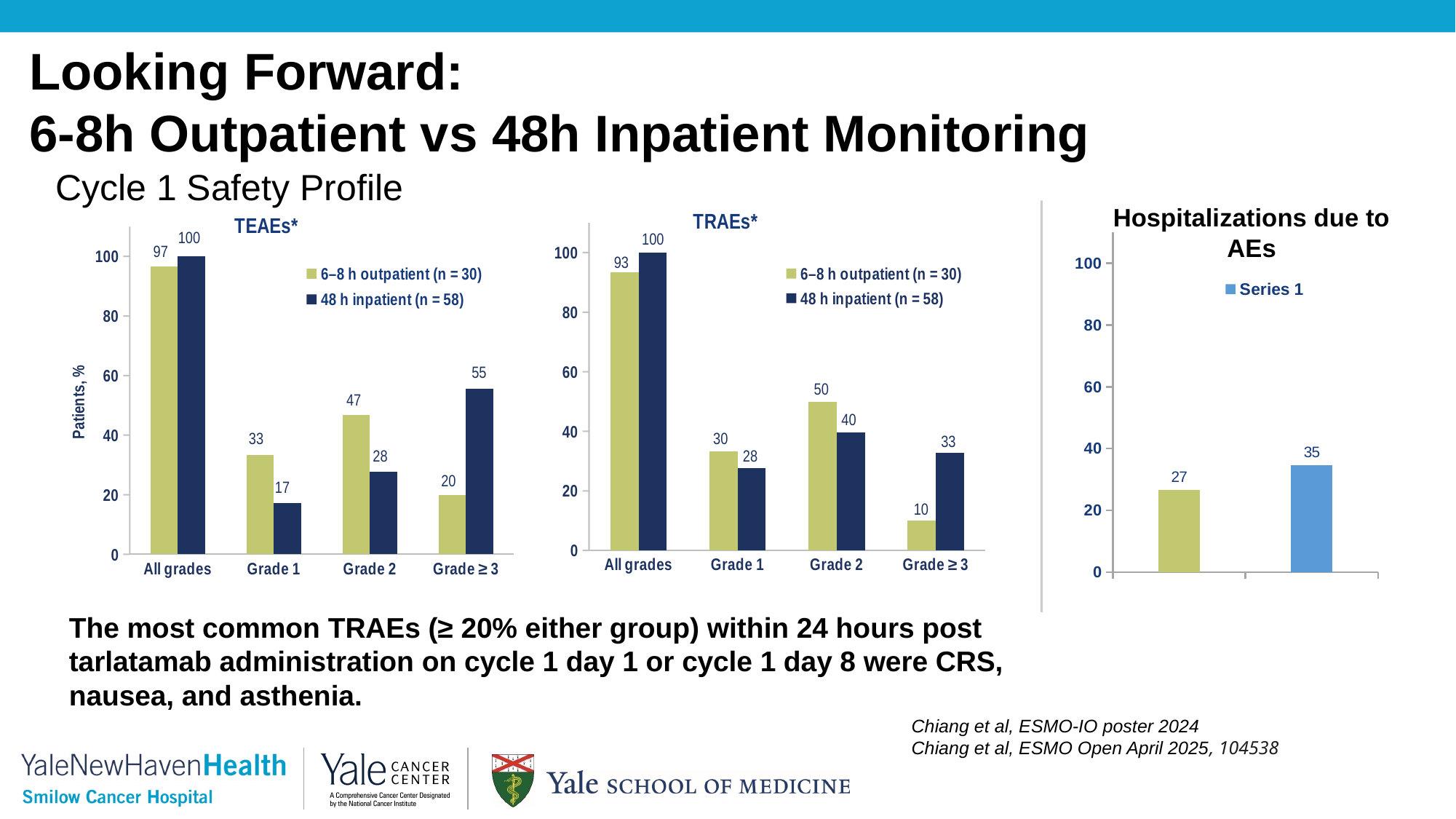
In the TEAEs* chart, what is the value for 48 h inpatient at Grade ≥ 3? 55 How many categories are shown on the x axis of the TEAEs* chart? 4 In the TRAEs* chart, what is the difference between the 48 h inpatient and 6–8 h outpatient values at Grade ≥ 3? 23 In the TEAEs* chart, which group has the higher value at Grade ≥ 3, 6–8 h outpatient or 48 h inpatient? 48 h inpatient In the Hospitalizations due to AEs chart, what is the highest value shown? 35 How many series does the legend of the TRAEs* chart list? 2 In the TEAEs* chart, what is the difference between the 6–8 h outpatient and 48 h inpatient values at Grade 1? 16 In the TEAEs* chart, what is the value for 6–8 h outpatient at Grade 2? 47 In the TRAEs* chart, which grade category has the lowest value for 6–8 h outpatient? Grade ≥ 3 What type of chart is the Hospitalizations due to AEs chart? Bar chart In the TRAEs* chart, what is the value for 6–8 h outpatient at All grades? 93 In the TRAEs* chart, what is the value for 48 h inpatient at Grade 2? 40